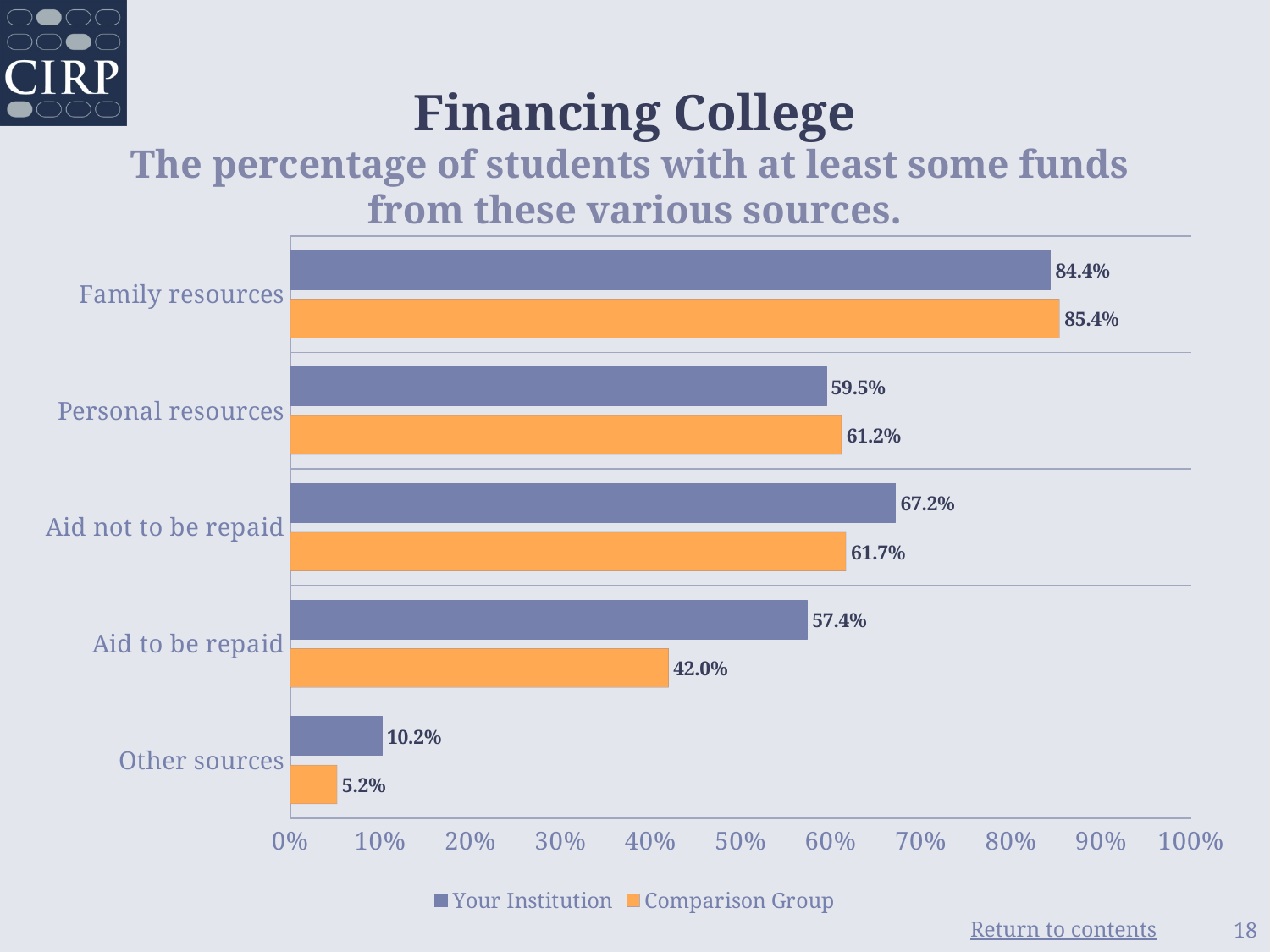
What kind of chart is shown on the slide? Bar chart What is the Comparison Group value for Aid to be repaid? 42.0% Which source has the lowest value for Your Institution? Other sources What is the difference between the Comparison Group and Your Institution for Personal resources? 1.7% Is the Comparison Group value for Aid to be repaid greater or less than 50%? less How many series does the legend list? 2 What is the Your Institution value for Other sources? 10.2% What is the difference between Your Institution and the Comparison Group for Aid to be repaid? 15.4% Which source has the highest value for the Comparison Group? Family resources For Aid not to be repaid, which is larger: Your Institution or the Comparison Group? Your Institution How many funding sources are shown on the chart? 5 What percentage of students at Your Institution have at least some funds from Family resources? 84.4%